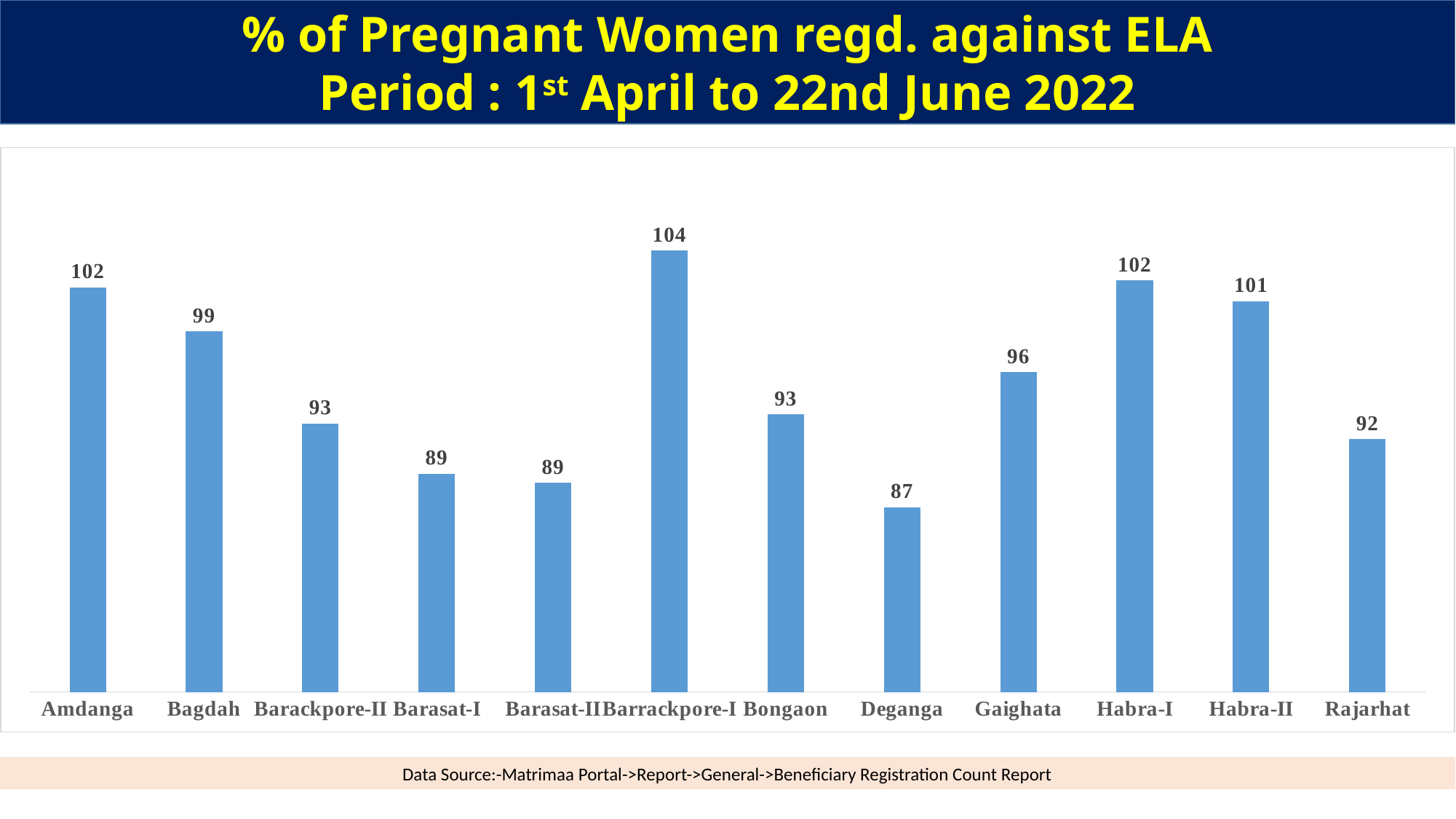
How many blocks are shown on the chart? 12 Which is larger, the value for Gaighata or the value for Bongaon? Gaighata What is the difference between the values for Barrackpore-I and Deganga? 17 What is the value for Deganga? 87 Which block has the highest value? Barrackpore-I Which block has the lowest value? Deganga What is the difference between the values for Amdanga and Bagdah? 3 What kind of chart is shown on the slide? Bar chart Which two blocks share the same value of 89? Barasat-I and Barasat-II What period does the chart title say the data covers? 1st April to 22nd June 2022 What is the value for Barrackpore-I? 104 What is the value for Habra-II? 101